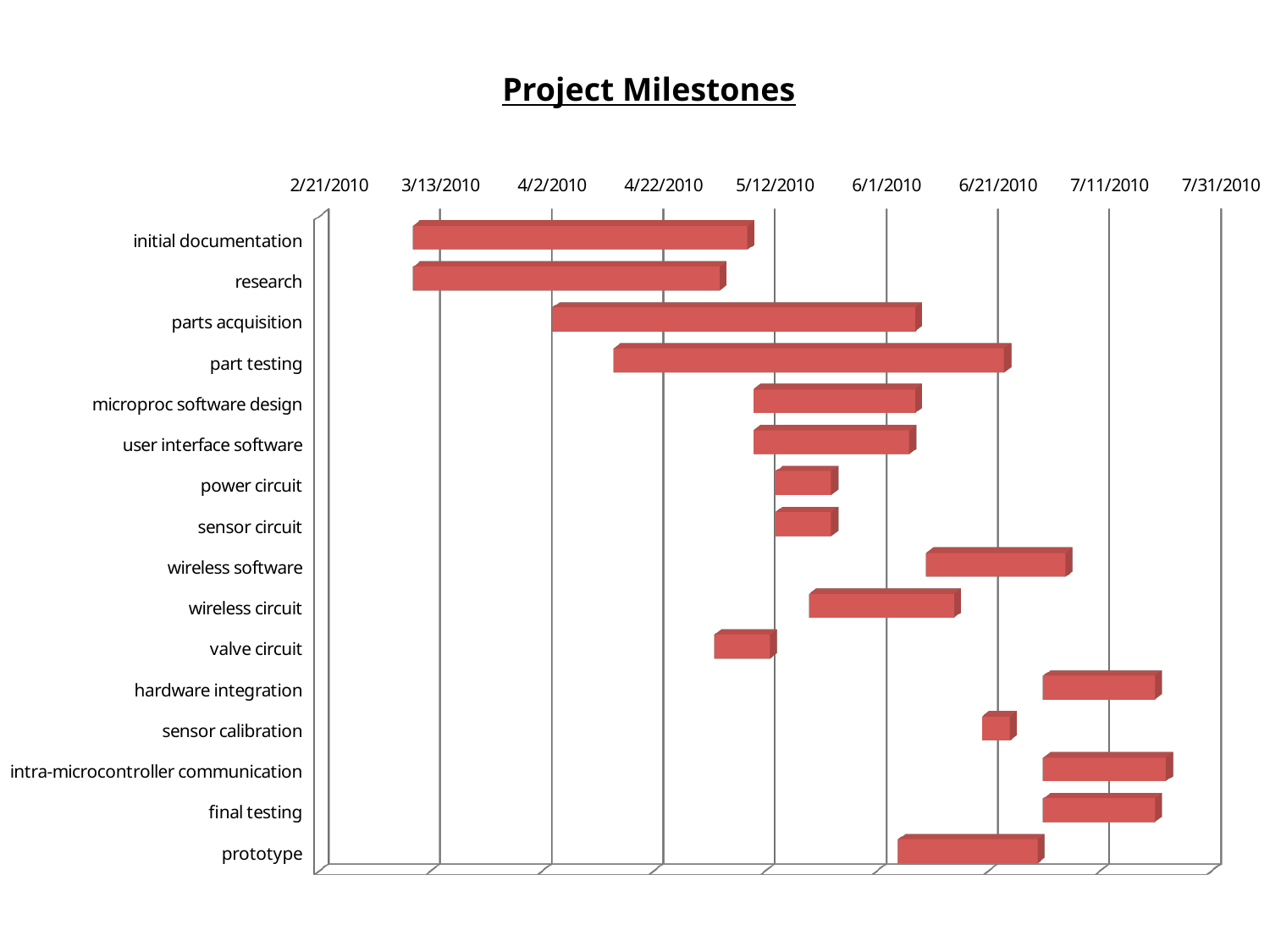
Which task starts earlier, wireless software or wireless circuit? wireless circuit Does the bar for wireless software start before or after 6/1/2010? after Which bar is longer, power circuit or wireless circuit? wireless circuit What is the first date label shown on the horizontal axis? 2/21/2010 What kind of chart is shown on the slide? bar chart Does the bar for valve circuit start before or after 5/12/2010? before What is the title of the chart? Project Milestones Does the bar for research end before or after 5/12/2010? before Which task has the longest bar in the chart? part testing How many tasks are listed on the vertical axis of the chart? 16 Which task has the shortest bar in the chart? sensor calibration